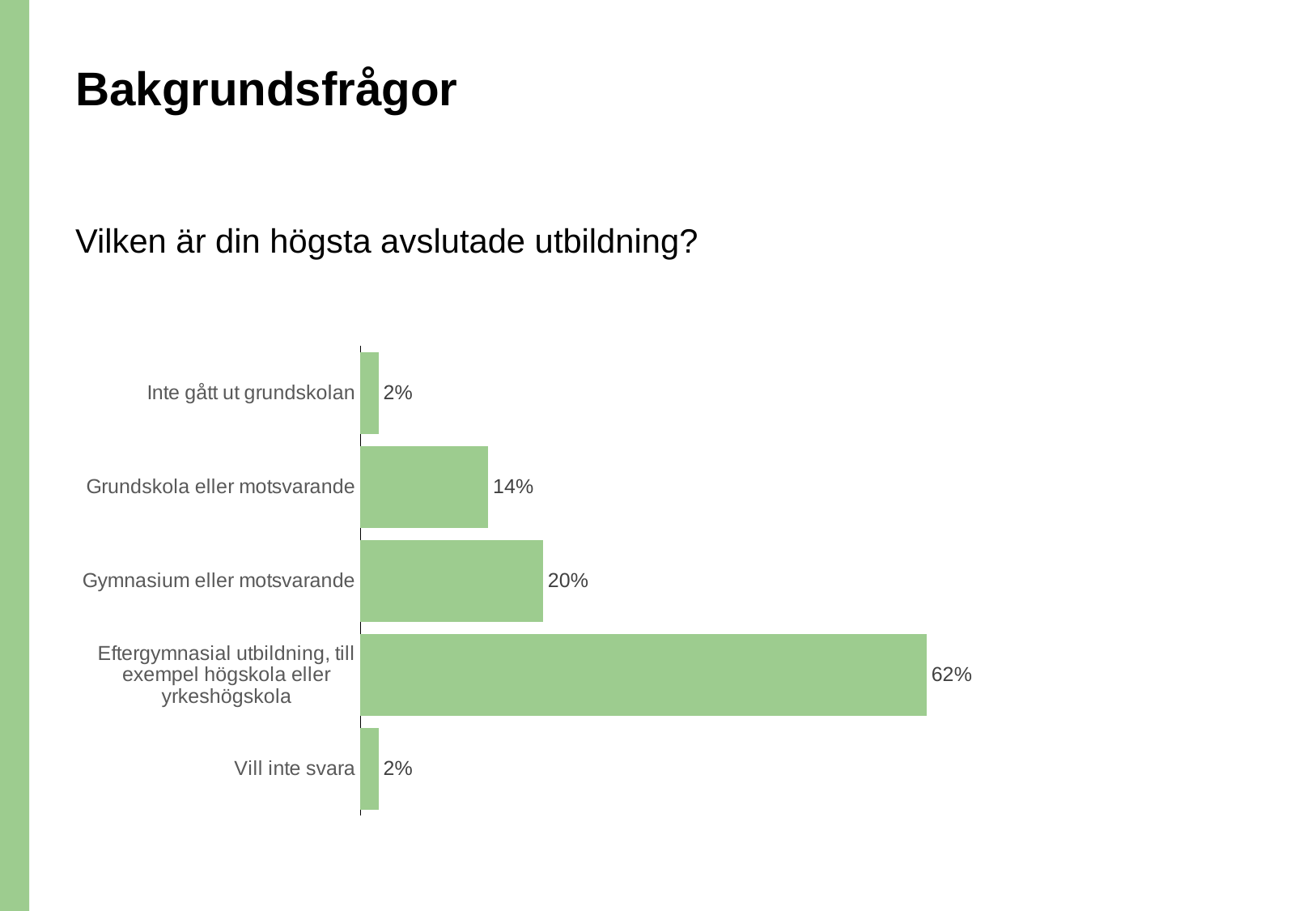
What is the value for "Eftergymnasial utbildning, till exempel högskola eller yrkeshögskola"? 62% How many categories are shown in the chart? 5 What is the difference between the values for "Gymnasium eller motsvarande" and "Grundskola eller motsvarande"? 6% What colour are the bars in the chart? Green What is the value for "Gymnasium eller motsvarande"? 20% What is the difference between the values for "Eftergymnasial utbildning, till exempel högskola eller yrkeshögskola" and "Gymnasium eller motsvarande"? 42% What is the value for "Vill inte svara"? 2% What is the value for "Grundskola eller motsvarande"? 14% What kind of chart is shown on the slide? Bar chart Which category has the highest value? Eftergymnasial utbildning, till exempel högskola eller yrkeshögskola What question does the chart answer, as written above it? Vilken är din högsta avslutade utbildning? Which is larger, the value for "Grundskola eller motsvarande" or the value for "Gymnasium eller motsvarande"? Gymnasium eller motsvarande